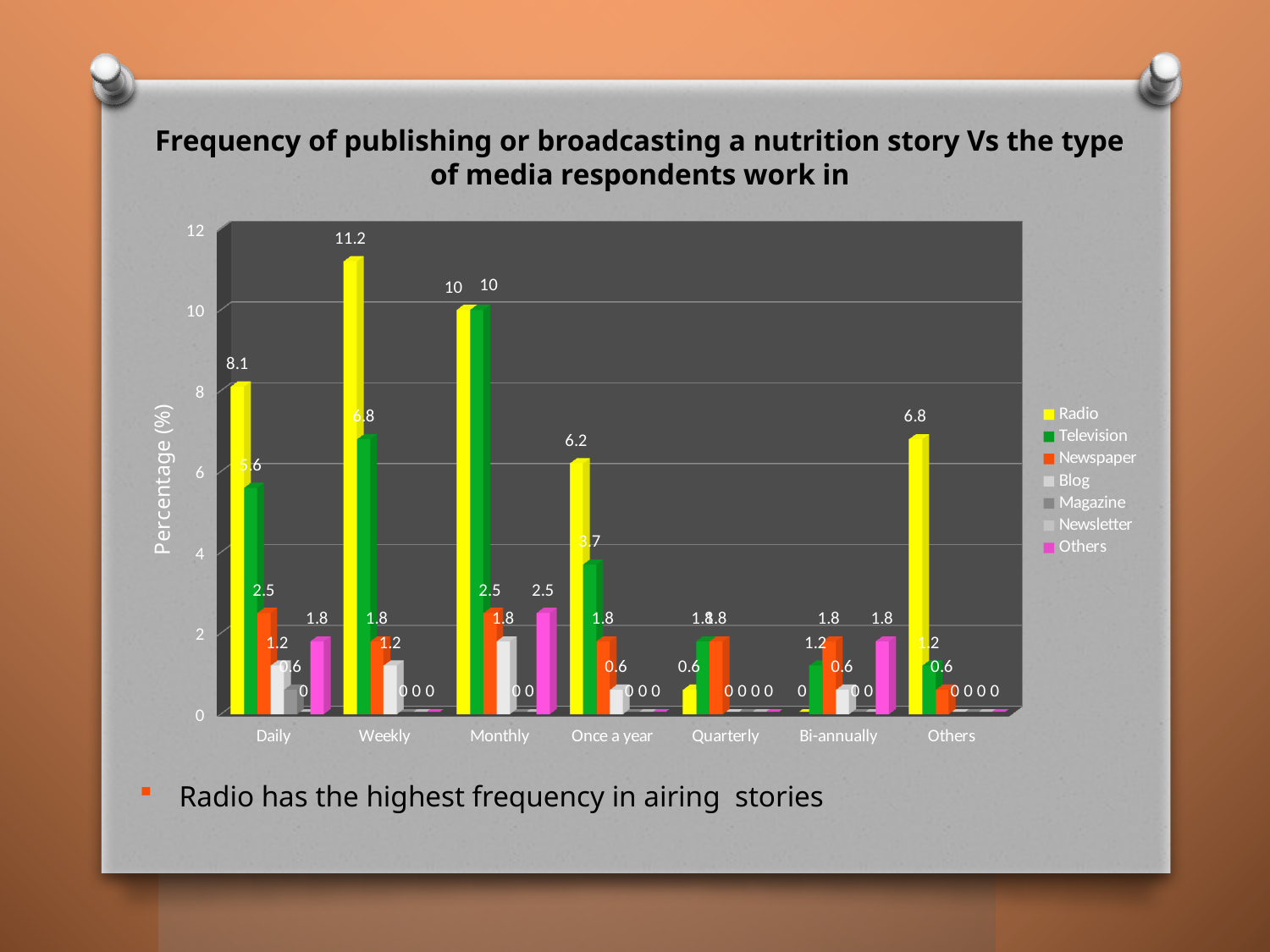
What is the Television value for Monthly? 10 Is the Radio value for Weekly greater or less than 10? greater In which category does Radio reach its highest value? Weekly What is the difference between the Radio and Television values for Daily? 2.5 What kind of chart is shown on the slide? bar chart How many series does the legend list? 7 What is the Radio value for Weekly? 11.2 For Once a year, which is larger: Radio or Television? Radio What is the label of the y axis? Percentage (%) In which category is the Radio value lowest? Bi-annually How many categories are shown on the x axis? 7 What is the Newspaper value for Daily? 2.5